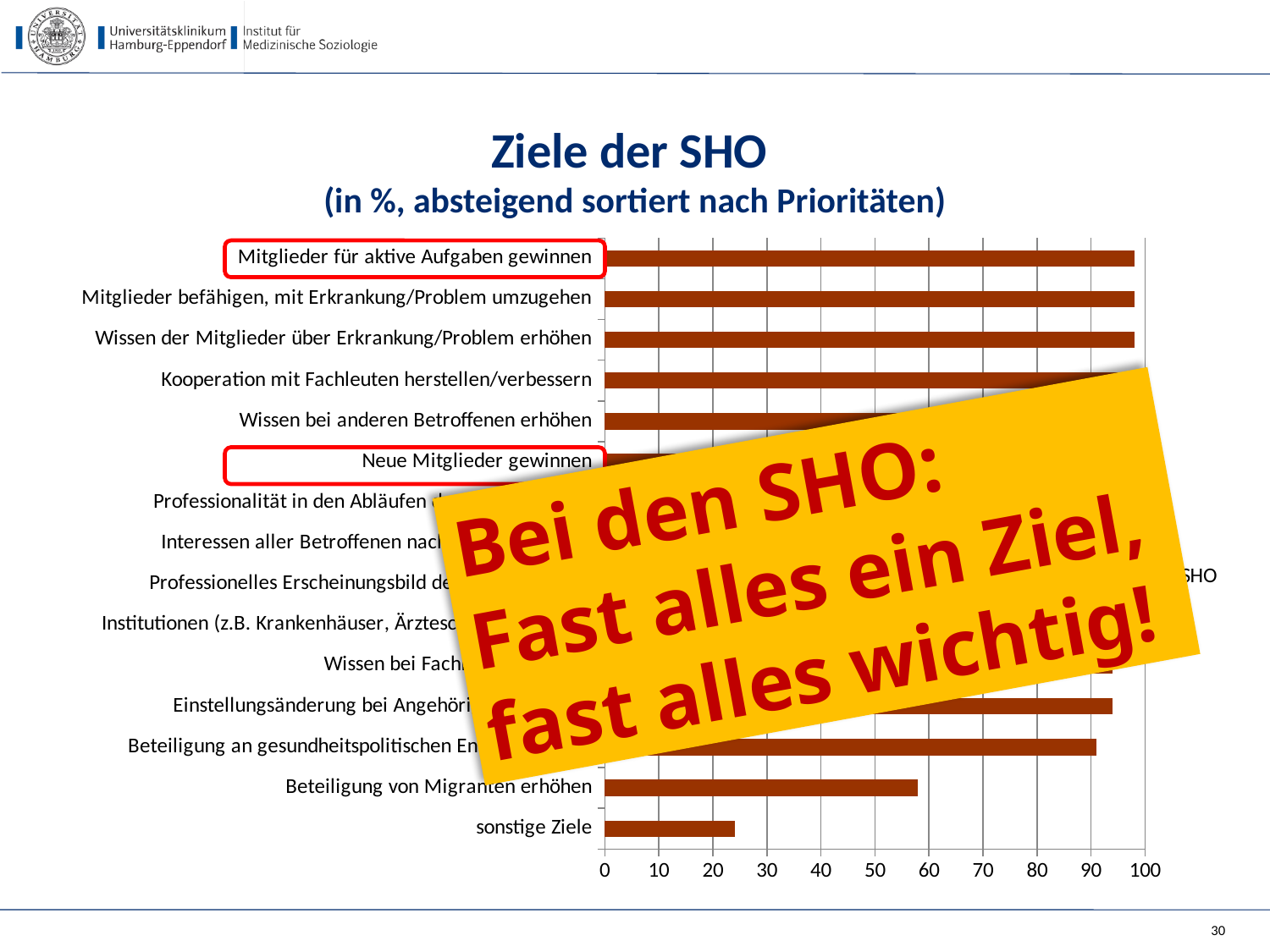
Is the value for "Mitglieder für aktive Aufgaben gewinnen" greater or less than 90? greater What is the title of the chart? Ziele der SHO (in %, absteigend sortiert nach Prioritäten) Do the bar values increase or decrease from the top of the chart to the bottom? decrease Is the value for "Beteiligung von Migranten erhöhen" greater or less than 50? greater Is the value for "sonstige Ziele" greater or less than 30? less What kind of chart is shown on the slide? bar chart Which has the larger value: "Beteiligung von Migranten erhöhen" or "sonstige Ziele"? Beteiligung von Migranten erhöhen How many categories (bars) does the chart show? 15 Which category has the lowest value? sonstige Ziele